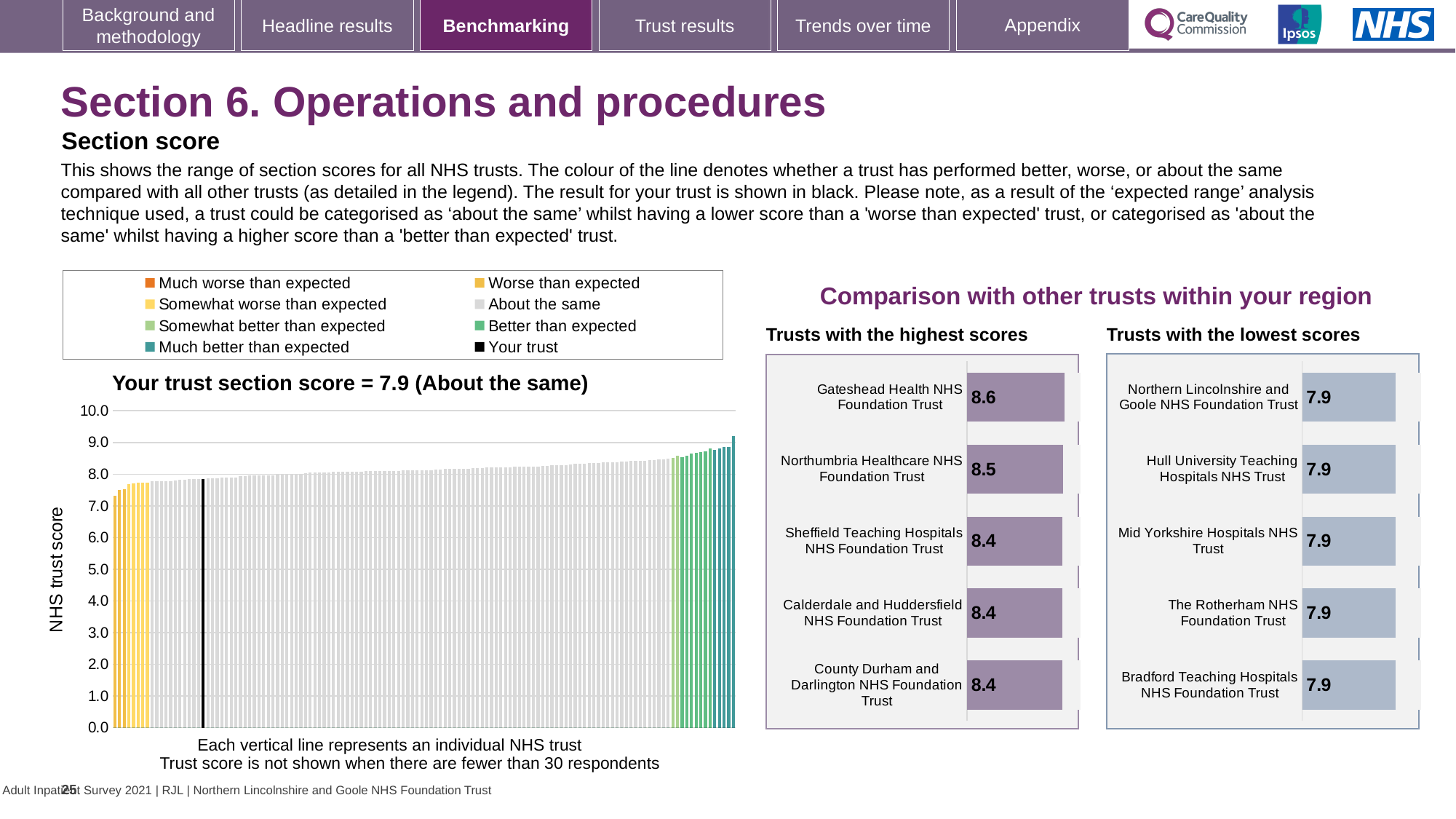
According to the title of the chart on the left, what is your trust's section score? 7.9 In the legend above the 'Your trust section score' chart, what colour represents 'Your trust'? Black How many trusts are shown in the 'Trusts with the lowest scores' chart? 5 In the 'Trusts with the highest scores' chart, which has the larger score: Northumbria Healthcare NHS Foundation Trust or Calderdale and Huddersfield NHS Foundation Trust? Northumbria Healthcare NHS Foundation Trust How many trusts are shown in the 'Trusts with the highest scores' chart? 5 What kind of chart is the 'Your trust section score' chart on the left? Bar chart In the 'Trusts with the lowest scores' chart, what is the score for Hull University Teaching Hospitals NHS Trust? 7.9 In the 'Trusts with the highest scores' chart, what is the score for Gateshead Health NHS Foundation Trust? 8.6 In the 'Trusts with the highest scores' chart, which trust has the highest score? Gateshead Health NHS Foundation Trust In the 'Trusts with the highest scores' chart, what is the score for Northumbria Healthcare NHS Foundation Trust? 8.5 In the 'Your trust section score' chart, do the bar values rise or fall from left to right? Rise In the 'Trusts with the highest scores' chart, what is the difference between the scores of Gateshead Health NHS Foundation Trust and Sheffield Teaching Hospitals NHS Foundation Trust? 0.2